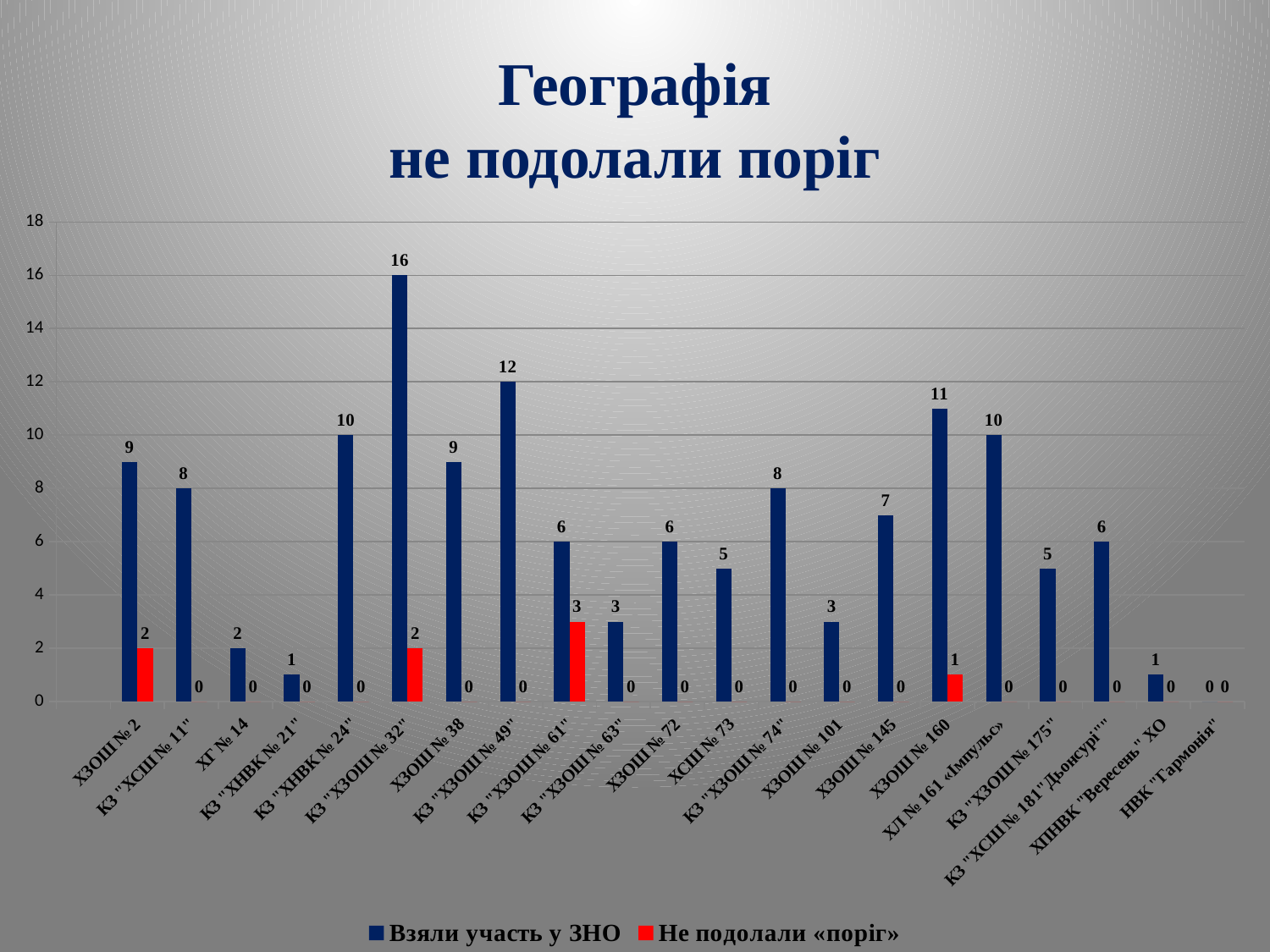
What colour are the bars for the series "Не подолали «поріг»"? red How many series does the legend list? 2 What is the value of "Не подолали «поріг»" for КЗ "ХЗОШ № 61"? 3 How many schools (categories) are shown on the x axis? 21 What is the value of "Взяли участь у ЗНО" for КЗ "ХЗОШ № 32"? 16 What type of chart is shown on the slide? bar chart Which school has the highest value for "Не подолали «поріг»"? КЗ "ХЗОШ № 61" What is the value of "Взяли участь у ЗНО" for ХЗОШ № 145? 7 What is the difference between "Взяли участь у ЗНО" and "Не подолали «поріг»" for ХЗОШ № 160? 10 Which school has the highest value for "Взяли участь у ЗНО"? КЗ "ХЗОШ № 32" Which is larger: "Взяли участь у ЗНО" for КЗ "ХЗОШ № 49" or for ХЛ № 161 «Імпульс»? КЗ "ХЗОШ № 49" What is the value of "Не подолали «поріг»" for ХЗОШ № 2? 2